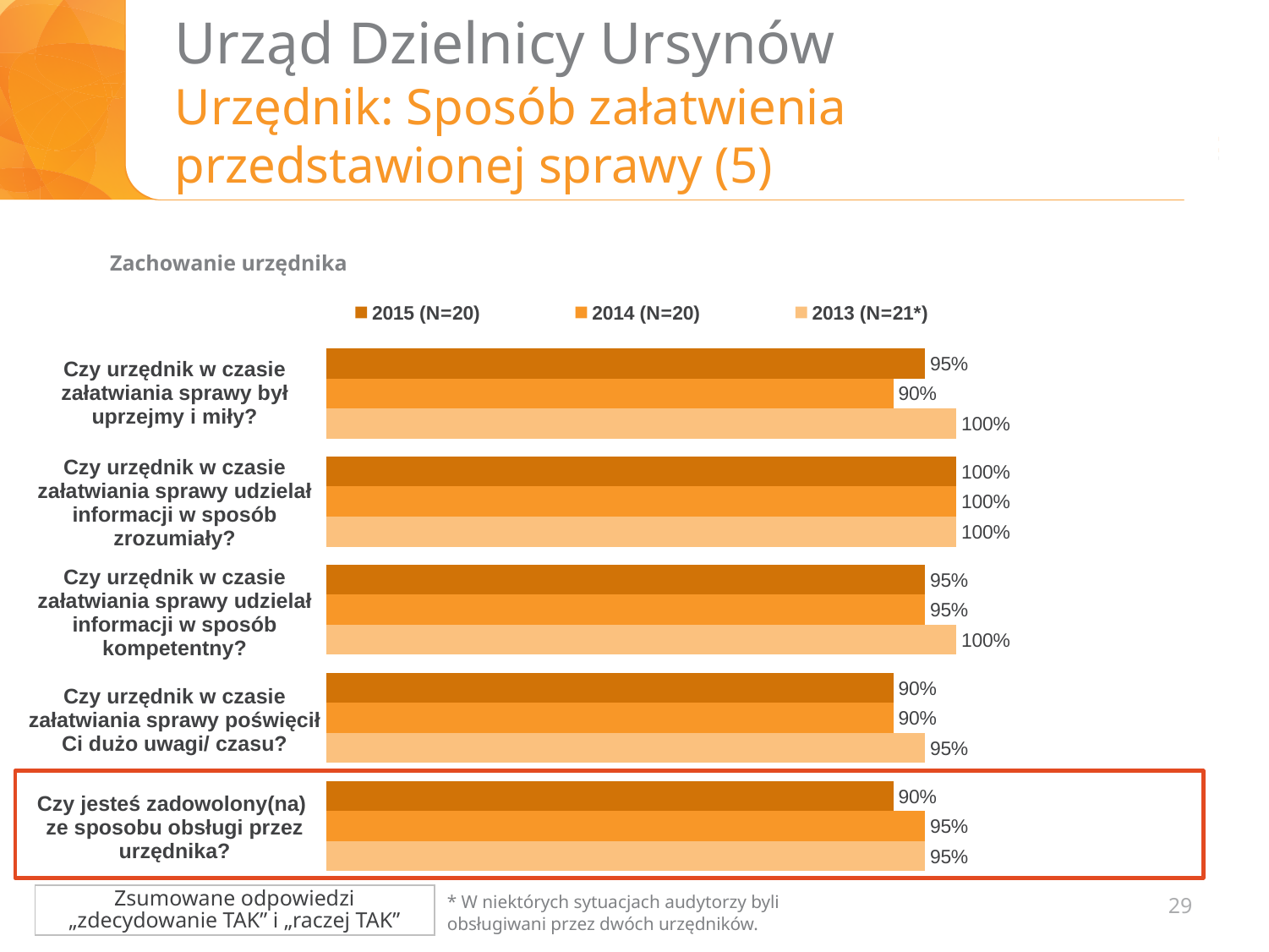
Which category has the lowest 2015 (N=20) value, "Czy urzędnik w czasie załatwiania sprawy udzielał informacji w sposób zrozumiały?" or "Czy jesteś zadowolony(na) ze sposobu obsługi przez urzędnika?"? Czy jesteś zadowolony(na) ze sposobu obsługi przez urzędnika? What is the 2014 (N=20) value for "Czy jesteś zadowolony(na) ze sposobu obsługi przez urzędnika?"? 95% Which category has the highest 2015 (N=20) value? Czy urzędnik w czasie załatwiania sprawy udzielał informacji w sposób zrozumiały? For "Czy urzędnik w czasie załatwiania sprawy był uprzejmy i miły?", is the 2013 (N=21*) value larger or smaller than the 2015 (N=20) value? larger What is the sample size shown in the legend for the 2013 series? N=21* What is the 2013 (N=21*) value for "Czy urzędnik w czasie załatwiania sprawy poświęcił Ci dużo uwagi/ czasu?"? 95% How many question categories are plotted on the chart? 5 What is the difference between the 2013 (N=21*) and 2014 (N=20) values for "Czy urzędnik w czasie załatwiania sprawy był uprzejmy i miły?"? 10% What is the 2015 (N=20) value for "Czy urzędnik w czasie załatwiania sprawy udzielał informacji w sposób kompetentny?"? 95% What type of chart is shown on the slide? bar chart What is the 2015 (N=20) value for "Czy urzędnik w czasie załatwiania sprawy był uprzejmy i miły?"? 95% How many series does the chart legend list? 3